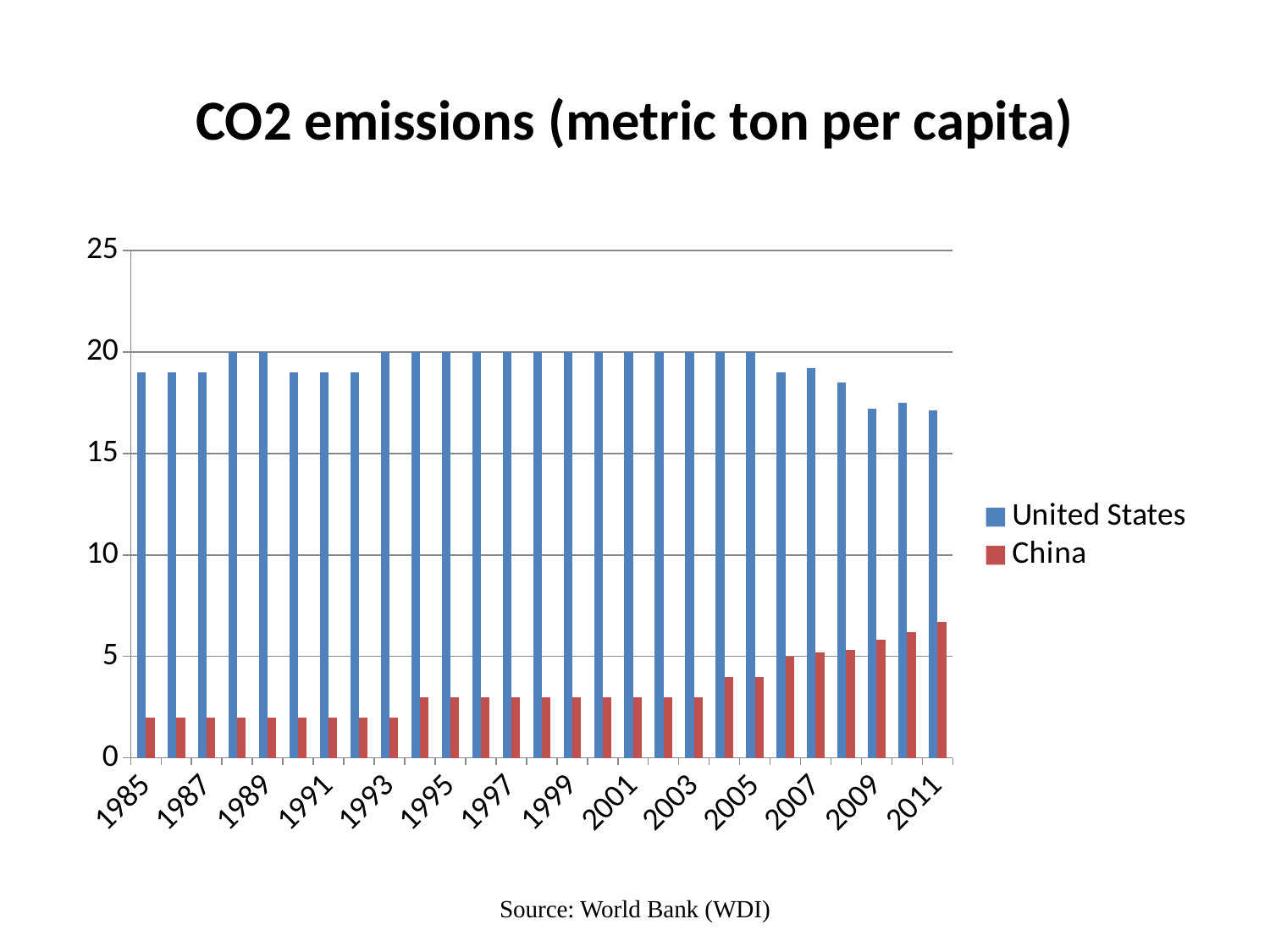
Which two series are shown in the legend? United States and China What is the title of the chart? CO2 emissions (metric ton per capita) Do the values for China rise or fall from 1985 to 2011? rise How many years are plotted along the x axis? 27 Is the value for the United States in 2011 greater or less than 20? less Is the value for China in 1985 greater or less than 5? less Is the value for China in 2011 greater or less than 5? greater Which series has the larger value in 2011, United States or China? United States How many series does the legend list? 2 In which year is the value for China highest? 2011 What kind of chart is shown on the slide? bar chart